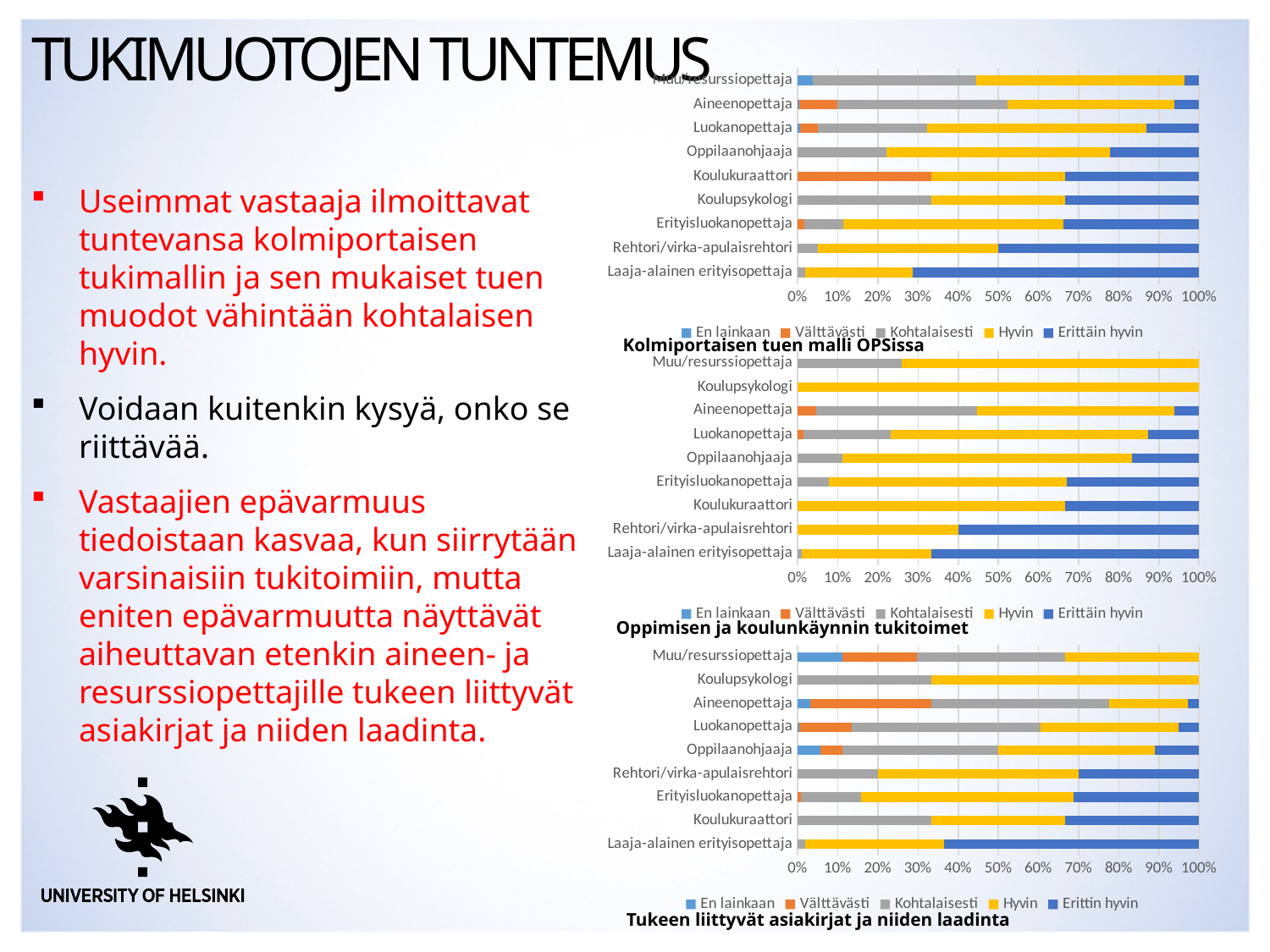
In the middle chart 'Oppimisen ja koulunkäynnin tukitoimet', is the Erittäin hyvin share for Rehtori/virka-apulaisrehtori greater or less than 50%? greater What kind of chart is the top chart, titled 'Kolmiportaisen tuen malli OPSissa'? Stacked bar chart What is the title of the bottom chart on the slide? Tukeen liittyvät asiakirjat ja niiden laadinta In the bottom chart 'Tukeen liittyvät asiakirjat ja niiden laadinta', is the Kohtalaisesti share for Muu/resurssiopettaja greater or less than 20%? greater In the bottom chart 'Tukeen liittyvät asiakirjat ja niiden laadinta', is the Erittäin hyvin share for Laaja-alainen erityisopettaja greater or less than 50%? greater How many series does the legend of the middle chart 'Oppimisen ja koulunkäynnin tukitoimet' list? 5 In the top chart 'Kolmiportaisen tuen malli OPSissa', which legend entry is shown in orange? Välttävästi How many categories are shown on the y axis of the bottom chart 'Tukeen liittyvät asiakirjat ja niiden laadinta'? 9 How many categories (respondent groups) are listed on the y axis of the top chart 'Kolmiportaisen tuen malli OPSissa'? 9